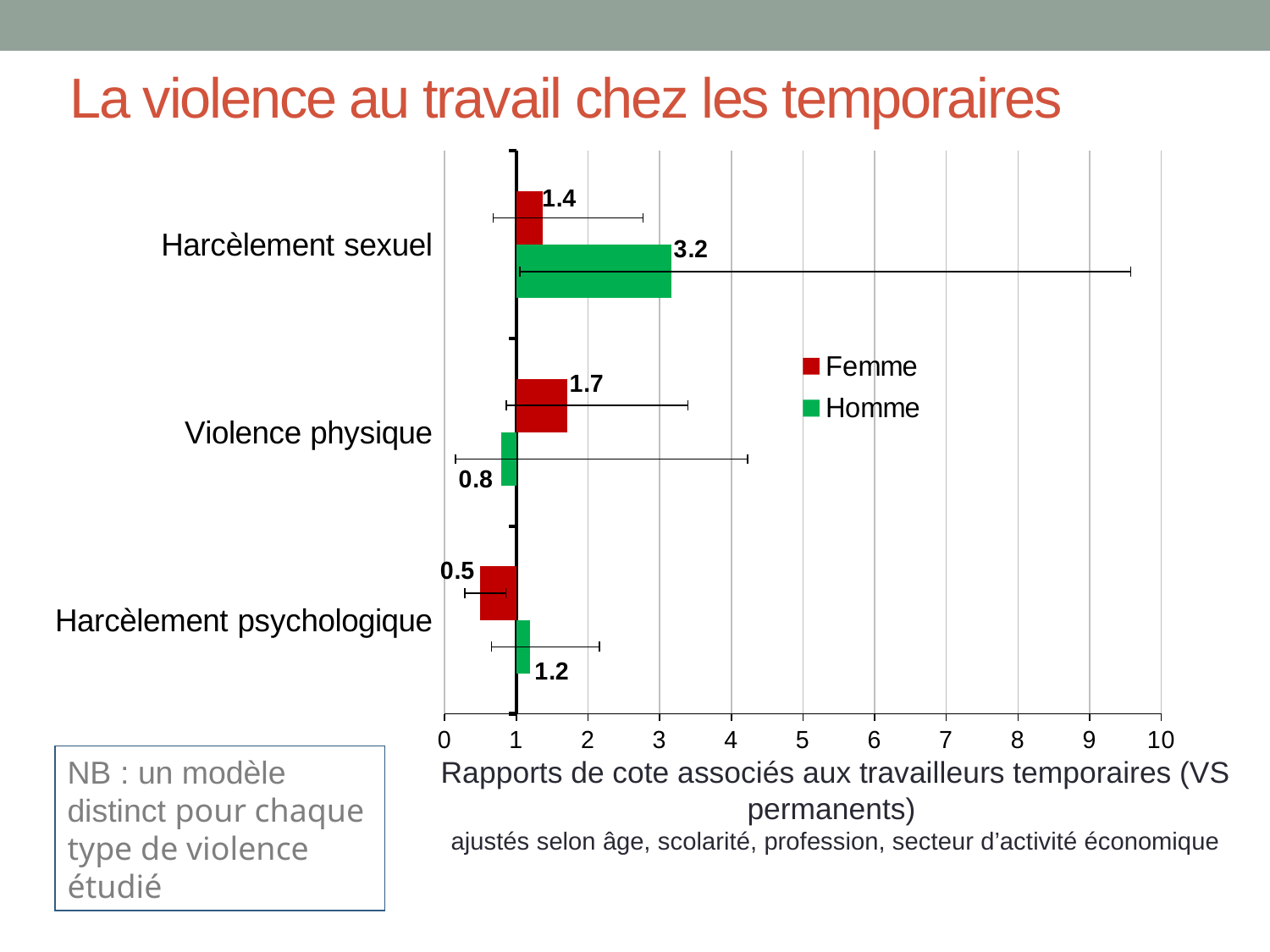
What is the odds ratio for Homme for Harcèlement psychologique? 1.2 Which category has the highest odds ratio for Homme? Harcèlement sexuel What is the odds ratio for Homme for Harcèlement sexuel? 3.2 What is the difference between the Homme and Femme odds ratios for Harcèlement sexuel? 1.8 What is the odds ratio for Femme for Harcèlement psychologique? 0.5 How many series does the legend list? 2 How many types of violence are shown on the chart? 3 Is the Homme odds ratio for Harcèlement sexuel greater or less than 3? greater Which category has the lowest odds ratio for Femme? Harcèlement psychologique What kind of chart is shown on the slide? Bar chart For Violence physique, which is larger, the Femme or the Homme odds ratio? Femme What is the odds ratio for Femme for Violence physique? 1.7